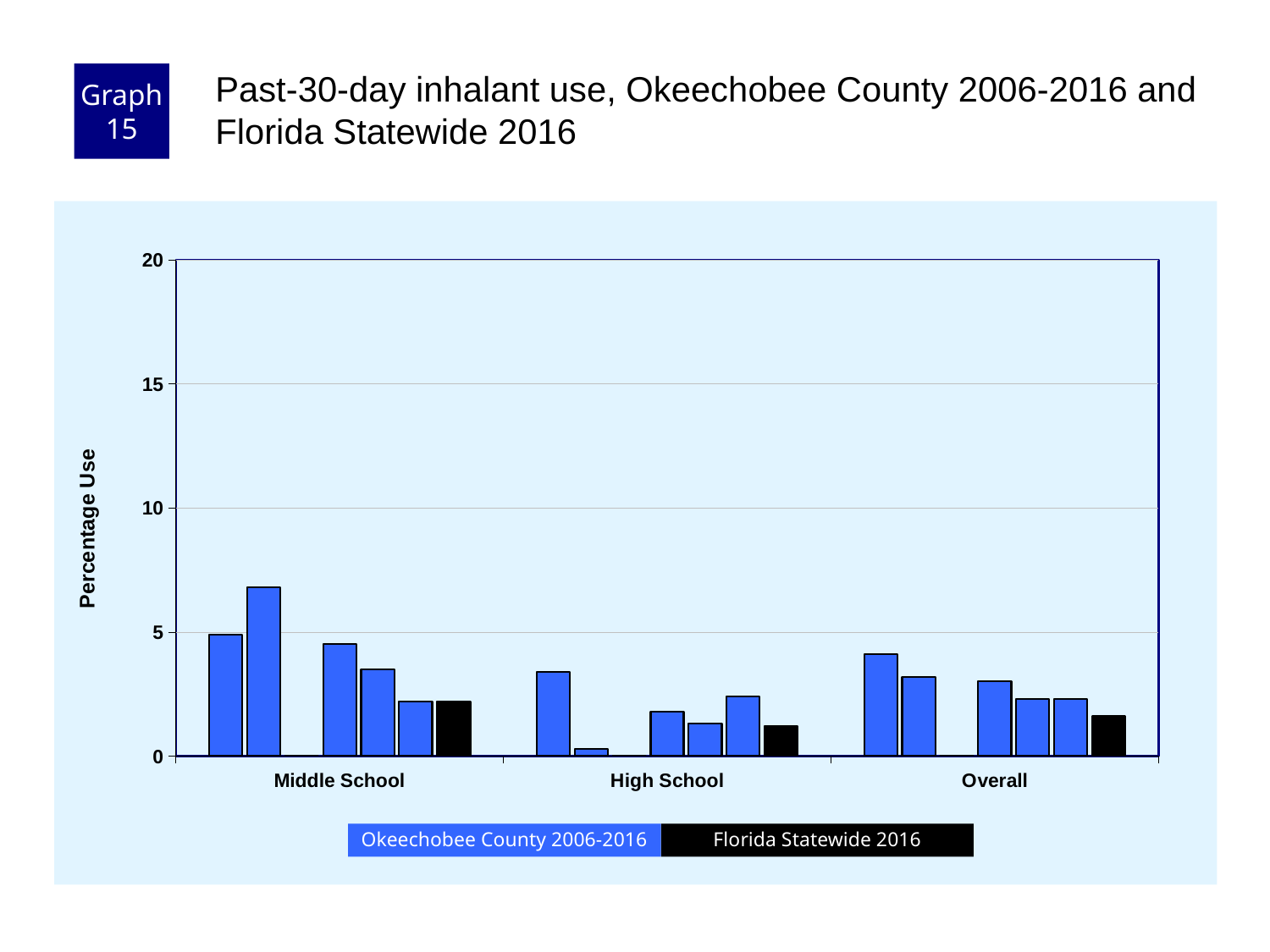
Is the Florida Statewide 2016 value for High School greater or less than 5? less Which is larger, the Florida Statewide 2016 value for Middle School or for High School? Middle School Is any bar on the chart greater than 10? No How many categories are shown on the x axis? 3 Is the tallest Okeechobee County bar in the Middle School group greater or less than 5? greater How many series does the legend list? 2 What kind of chart is shown on the slide? bar chart What is the label of the y axis? Percentage Use Which category has the lowest Florida Statewide 2016 value? High School What are the three categories on the x axis? Middle School, High School, Overall Which category has the highest Florida Statewide 2016 value? Middle School